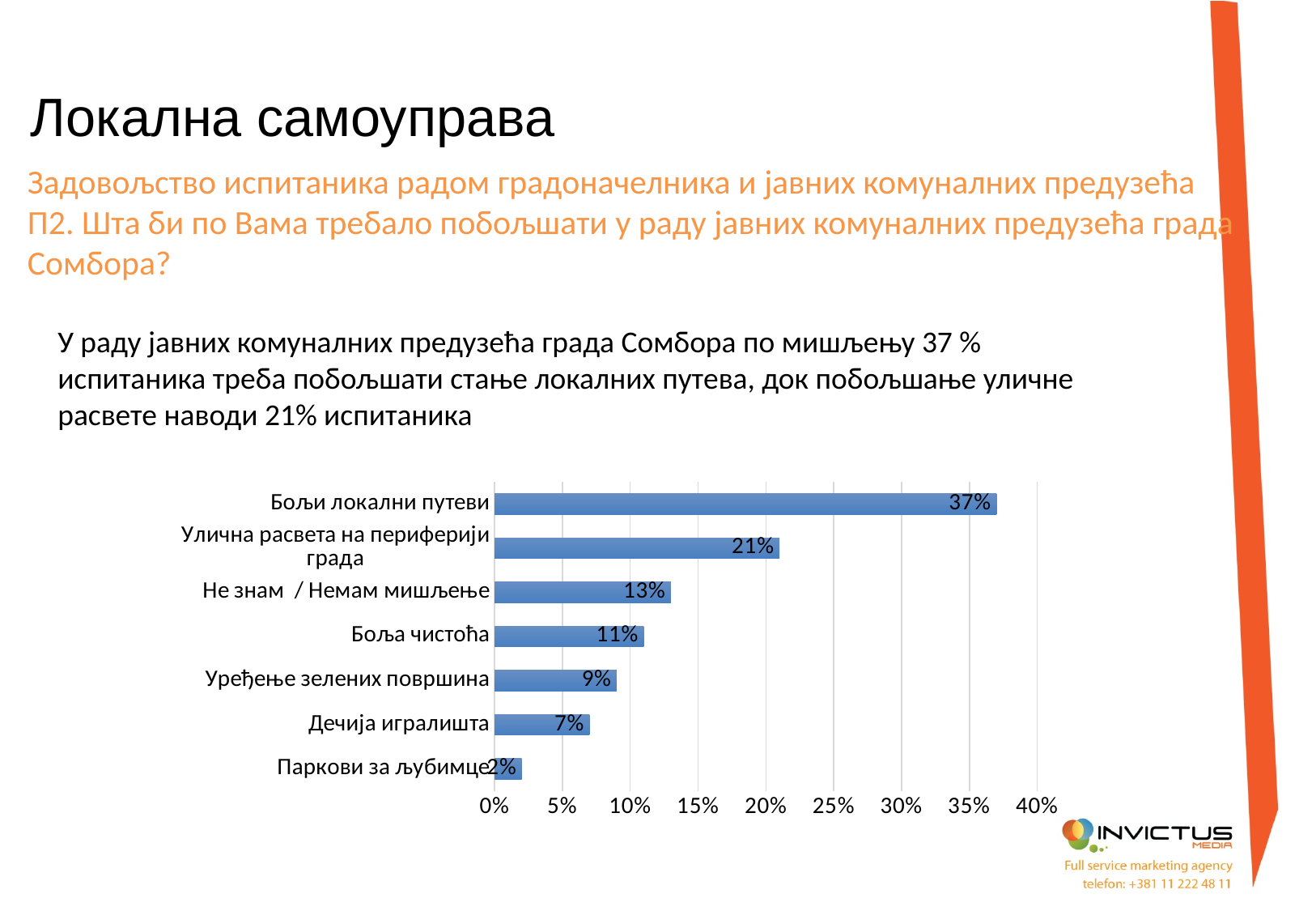
Which is larger, the value for Уређење зелених површина or the value for Дечија игралишта? Уређење зелених површина What kind of chart is shown on the slide? bar chart What is the value for Боља чистоћа? 11% What is the value for Улична расвета на периферији града? 21% What is the difference between the values for Бољи локални путеви and Улична расвета на периферији града? 16% What is the value for Паркови за љубимце? 2% Which category has the lowest value? Паркови за љубимце What is the value for Бољи локални путеви? 37% How many categories are shown in the chart? 7 What is the maximum value shown on the horizontal axis? 40% Is the value for Не знам / Немам мишљење greater or less than 10%? greater Which category has the highest value? Бољи локални путеви